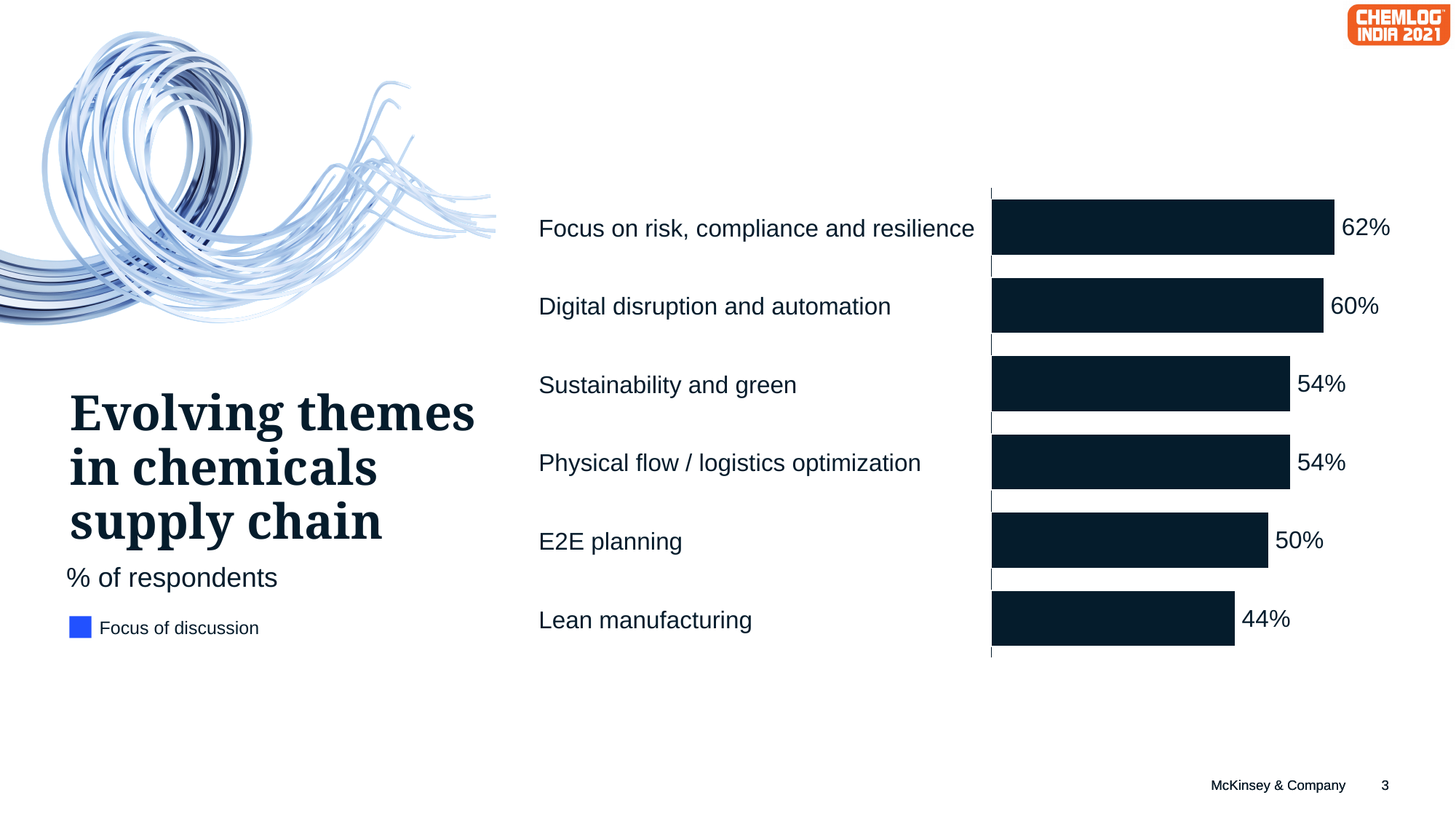
What unit is the chart measured in, according to the subtitle? % of respondents How many themes are shown in the chart? 6 Which theme has the lowest percentage of respondents? Lean manufacturing What is the difference between 'Sustainability and green' and 'E2E planning'? 4% What percentage of respondents chose 'Focus on risk, compliance and resilience'? 62% Which theme has the highest percentage of respondents? Focus on risk, compliance and resilience What is the difference between the values for 'Focus on risk, compliance and resilience' and 'Lean manufacturing'? 18% What kind of chart is shown on the slide? Bar chart Which is larger, the value for 'Digital disruption and automation' or 'E2E planning'? Digital disruption and automation What is the value for 'Lean manufacturing'? 44% What is the value for 'Digital disruption and automation'? 60% What is the value for 'E2E planning'? 50%